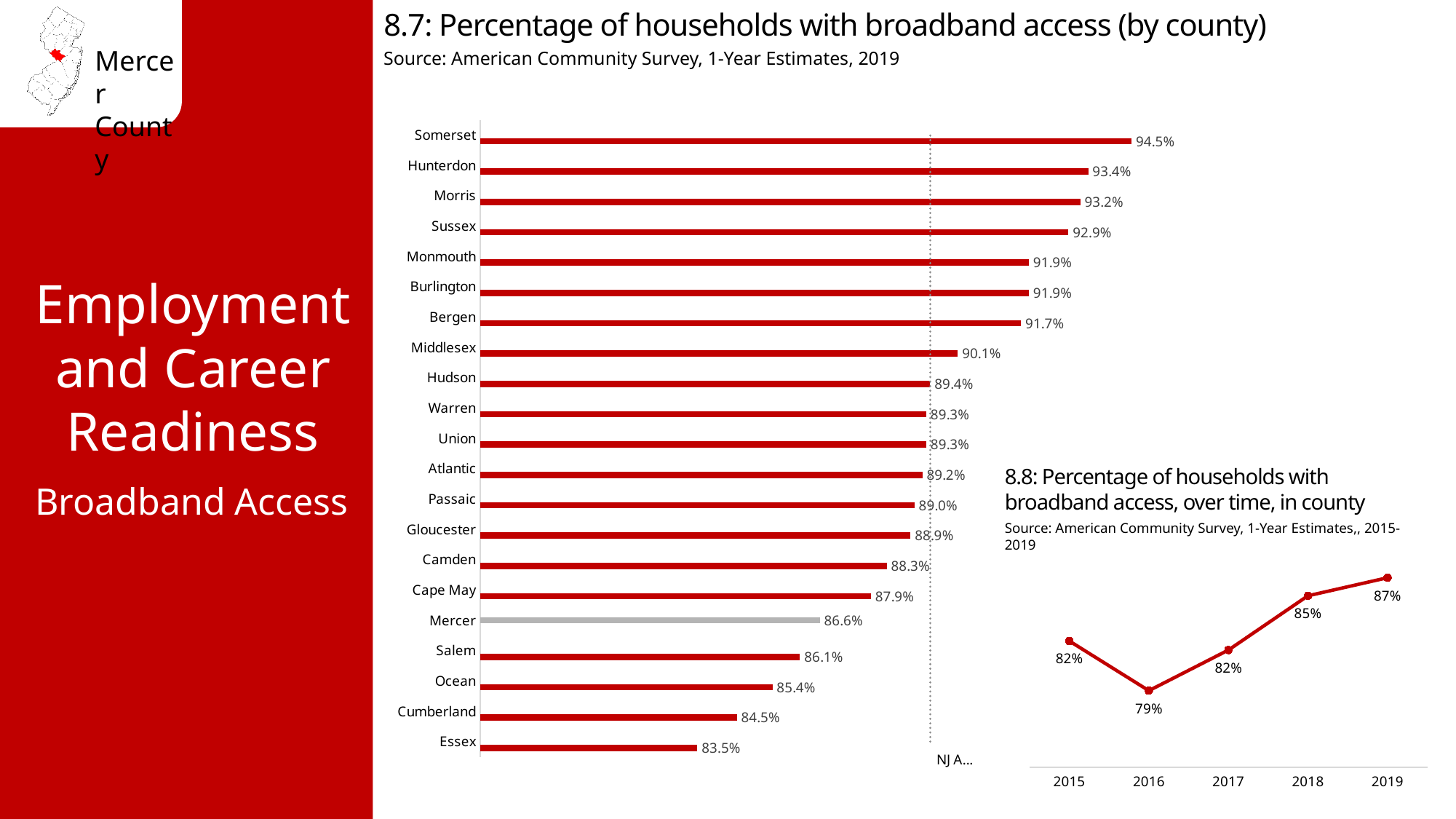
In the chart '8.8: Percentage of households with broadband access, over time, in county', which year has the highest value? 2019 In the chart '8.8: Percentage of households with broadband access, over time, in county', what is the value for 2016? 79% In the chart '8.8: Percentage of households with broadband access, over time, in county', what is the difference between 2019 and 2016? 8% In the chart '8.7: Percentage of households with broadband access (by county)', which county has the highest value? Somerset In the chart '8.7: Percentage of households with broadband access (by county)', how many counties are shown? 21 In the chart '8.7: Percentage of households with broadband access (by county)', what is the value for Somerset? 94.5% What kind of chart is '8.7: Percentage of households with broadband access (by county)'? Bar chart In the chart '8.7: Percentage of households with broadband access (by county)', what is the difference between Somerset and Essex? 11.0% In the chart '8.7: Percentage of households with broadband access (by county)', which is larger, Hudson or Camden? Hudson What kind of chart is '8.8: Percentage of households with broadband access, over time, in county'? Line chart In the chart '8.7: Percentage of households with broadband access (by county)', which county has the lowest value? Essex In the chart '8.7: Percentage of households with broadband access (by county)', what is the value for Mercer? 86.6%